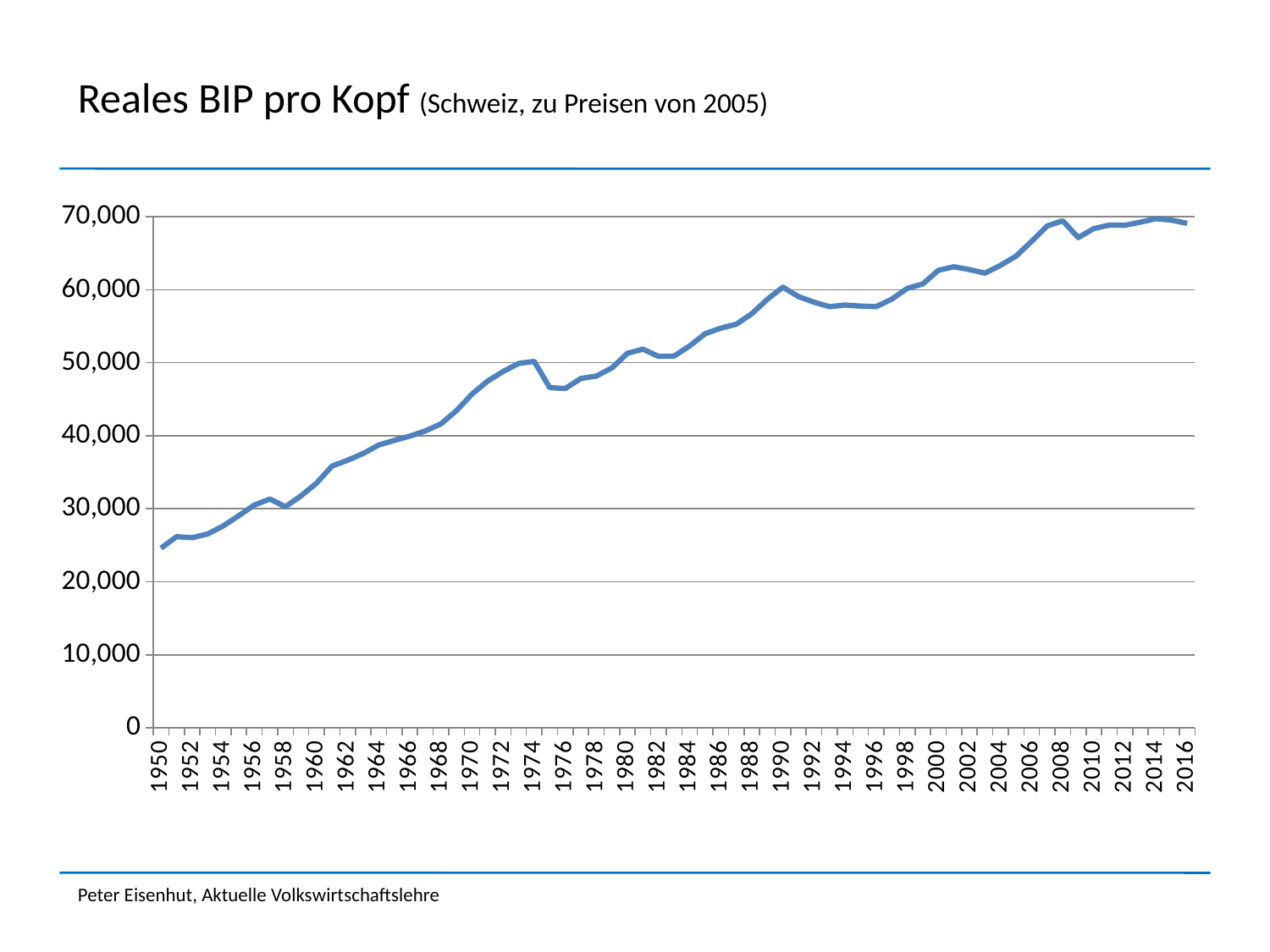
Which is larger, the value for 1990 or the value for 1996? 1990 What kind of chart is shown on the slide? line chart Is the value for 1990 greater or less than 50,000? greater Is the value for 1950 greater or less than 30,000? less How many year labels are shown on the x axis? 34 Is the value for 2016 greater or less than 60,000? greater Overall, do the values rise or fall from 1950 to 2016? rise What is the title of the chart? Reales BIP pro Kopf (Schweiz, zu Preisen von 2005) Which year has the lowest value on the chart? 1950 Which is larger, the value for 1974 or the value for 1976? 1974